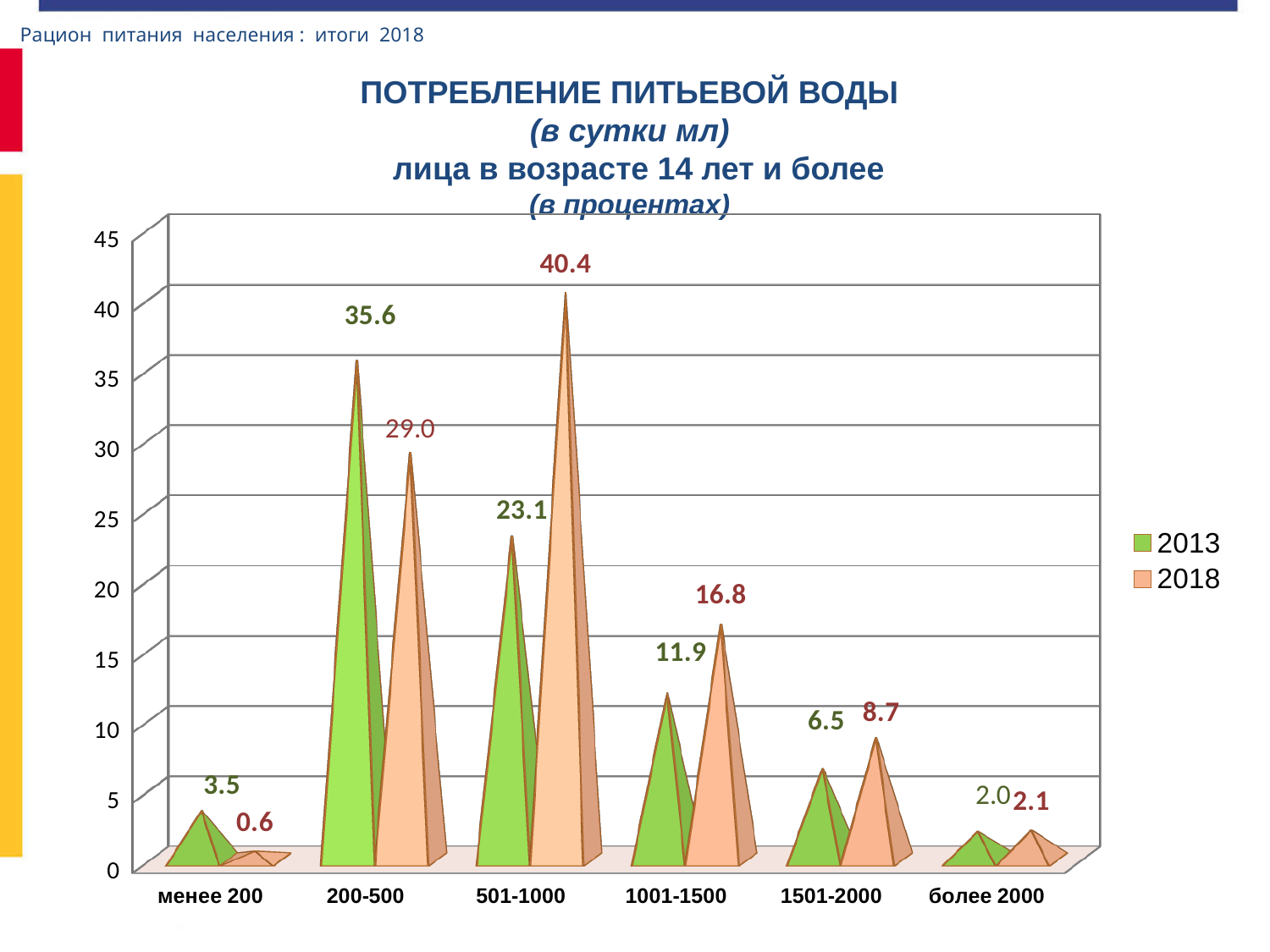
What kind of chart is shown on the slide? bar chart How many categories are shown on the x axis? 6 Which category has the lowest value for the 2018 series? менее 200 What is the value for 2018 in the менее 200 category? 0.6 Which series is shown in green in the legend? 2013 In the 501-1000 category, which series has the larger value, 2013 or 2018? 2018 Which category has the highest value for the 2013 series? 200-500 How many series does the legend list? 2 What is the difference between the 2018 and 2013 values in the 1001-1500 category? 4.9 What is the value for 2013 in the 200-500 category? 35.6 What is the value for 2013 in the 1501-2000 category? 6.5 What is the value for 2018 in the 501-1000 category? 40.4